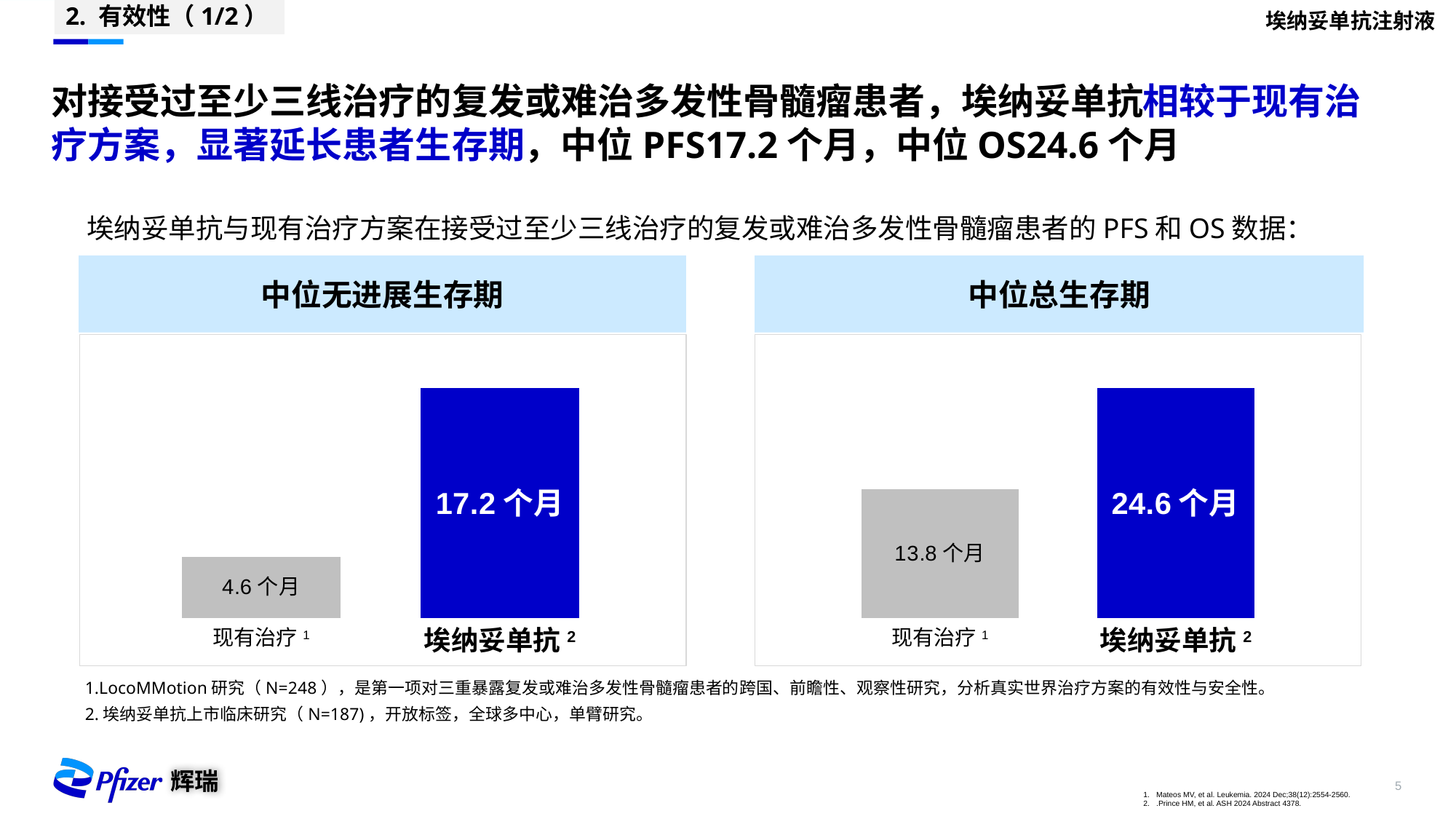
在“中位无进展生存期”图中，现有治疗的数值是多少？ 4.6 个月 在“中位无进展生存期”图中，埃纳妥单抗与现有治疗的数值相差多少？ 12.6 个月 “中位总生存期”图是什么类型的图表？ 条形图 在“中位总生存期”图中，现有治疗的数值是多少？ 13.8 个月 在“中位无进展生存期”图中，埃纳妥单抗的数值是多少？ 17.2 个月 在“中位总生存期”图中，埃纳妥单抗与现有治疗的数值相差多少？ 10.8 个月 在“中位总生存期”图中，哪个类别的数值最低？ 现有治疗 在“中位无进展生存期”图中，哪个类别的数值最高？ 埃纳妥单抗 在“中位总生存期”图中，埃纳妥单抗的数值是多少？ 24.6 个月 在“中位无进展生存期”图中，埃纳妥单抗的柱子是什么颜色？ 蓝色 “中位无进展生存期”图中有多少个类别？ 2 在“中位总生存期”图中，埃纳妥单抗和现有治疗哪个数值更大？ 埃纳妥单抗